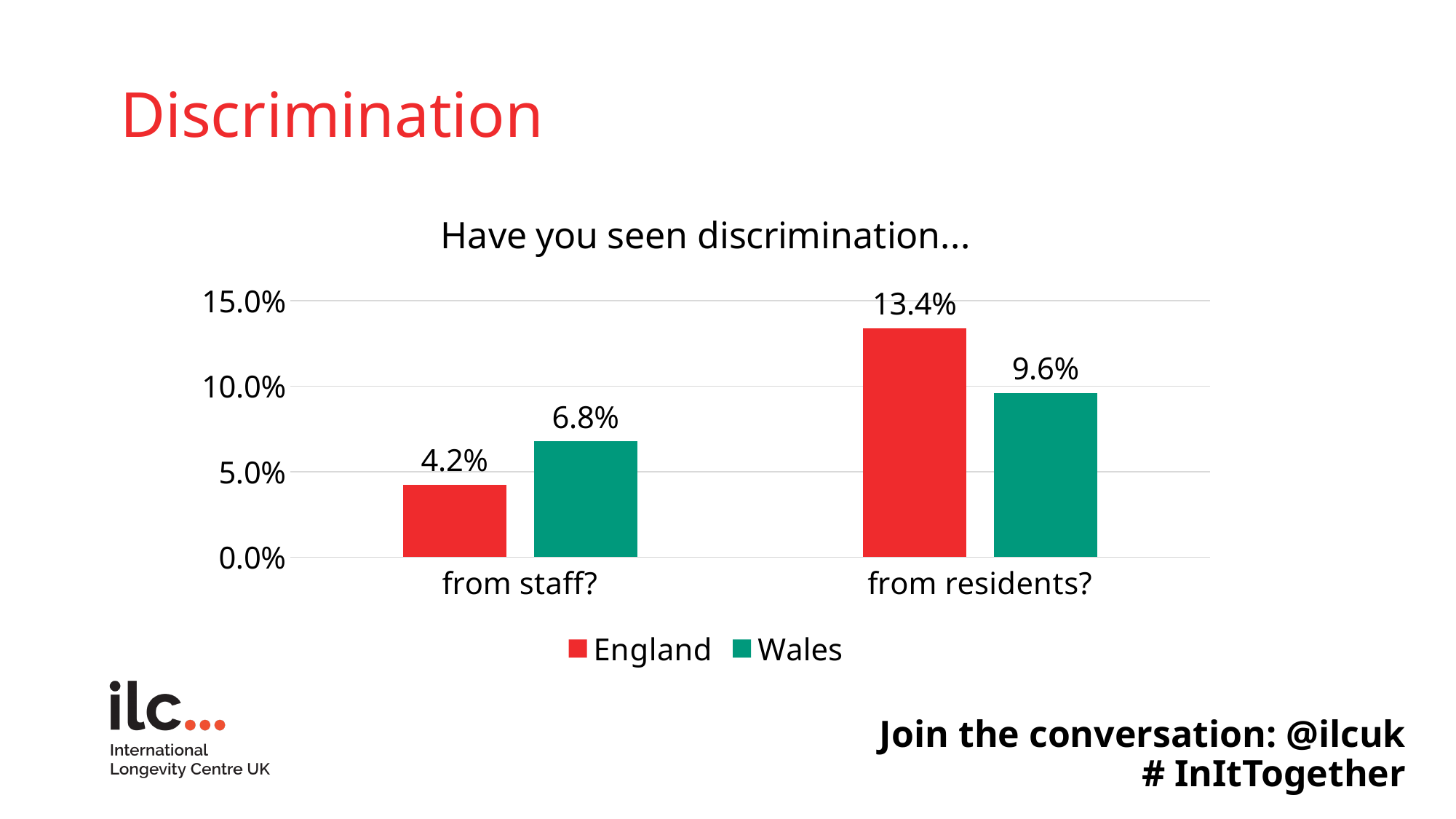
What is the value for England for 'from staff?' 4.2% How many categories are shown on the x axis? 2 How many series does the legend list? 2 For 'from staff?', which is larger, England or Wales? Wales What is the value for England for 'from residents?' 13.4% Is the value for Wales for 'from residents?' greater or less than 10.0%? less Which bar has the lowest value in the chart? England, from staff? What is the difference between Wales and England for 'from staff?' 2.6% What is the difference between England and Wales for 'from residents?' 3.8% What is the value for Wales for 'from residents?' 9.6% Which bar has the highest value in the chart? England, from residents? What kind of chart is shown on the slide? bar chart